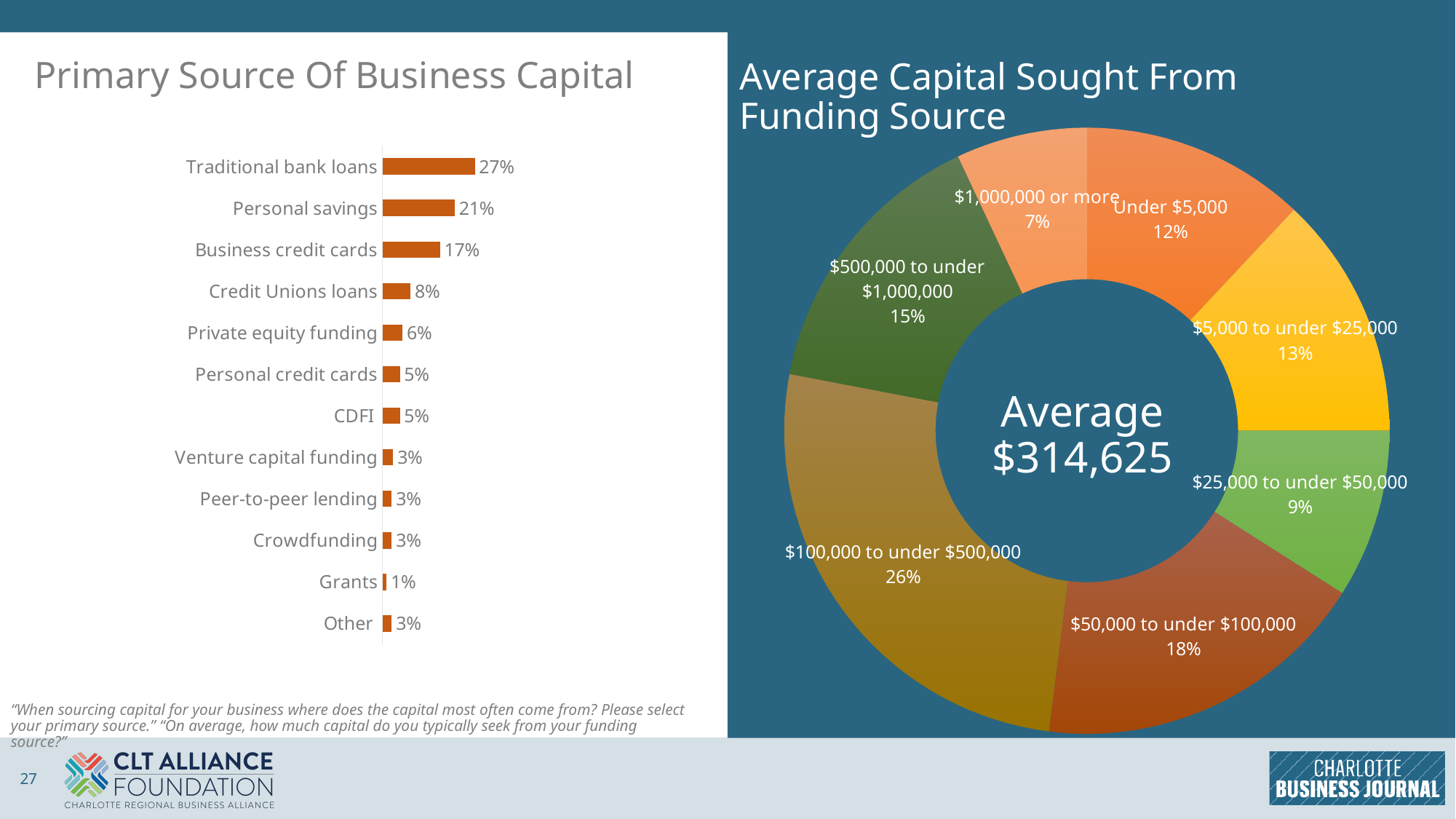
In the 'Primary Source Of Business Capital' chart, how many categories are plotted? 12 What kind of chart is the 'Primary Source Of Business Capital' chart? Bar chart In the 'Primary Source Of Business Capital' chart, which category has the highest value? Traditional bank loans In the 'Primary Source Of Business Capital' chart, which category has the lowest value? Grants In the 'Average Capital Sought From Funding Source' chart, what share is shown for $100,000 to under $500,000? 26% In the 'Average Capital Sought From Funding Source' chart, how many segments are there? 7 In the 'Average Capital Sought From Funding Source' chart, which is larger: $50,000 to under $100,000 or $25,000 to under $50,000? $50,000 to under $100,000 In the 'Average Capital Sought From Funding Source' chart, what share is shown for $1,000,000 or more? 7% In the 'Primary Source Of Business Capital' chart, what is the difference between Personal savings and Credit Unions loans? 13% In the 'Primary Source Of Business Capital' chart, what percentage is shown for Traditional bank loans? 27% In the 'Primary Source Of Business Capital' chart, what percentage is shown for Business credit cards? 17% What average value is printed in the center of the 'Average Capital Sought From Funding Source' chart? $314,625